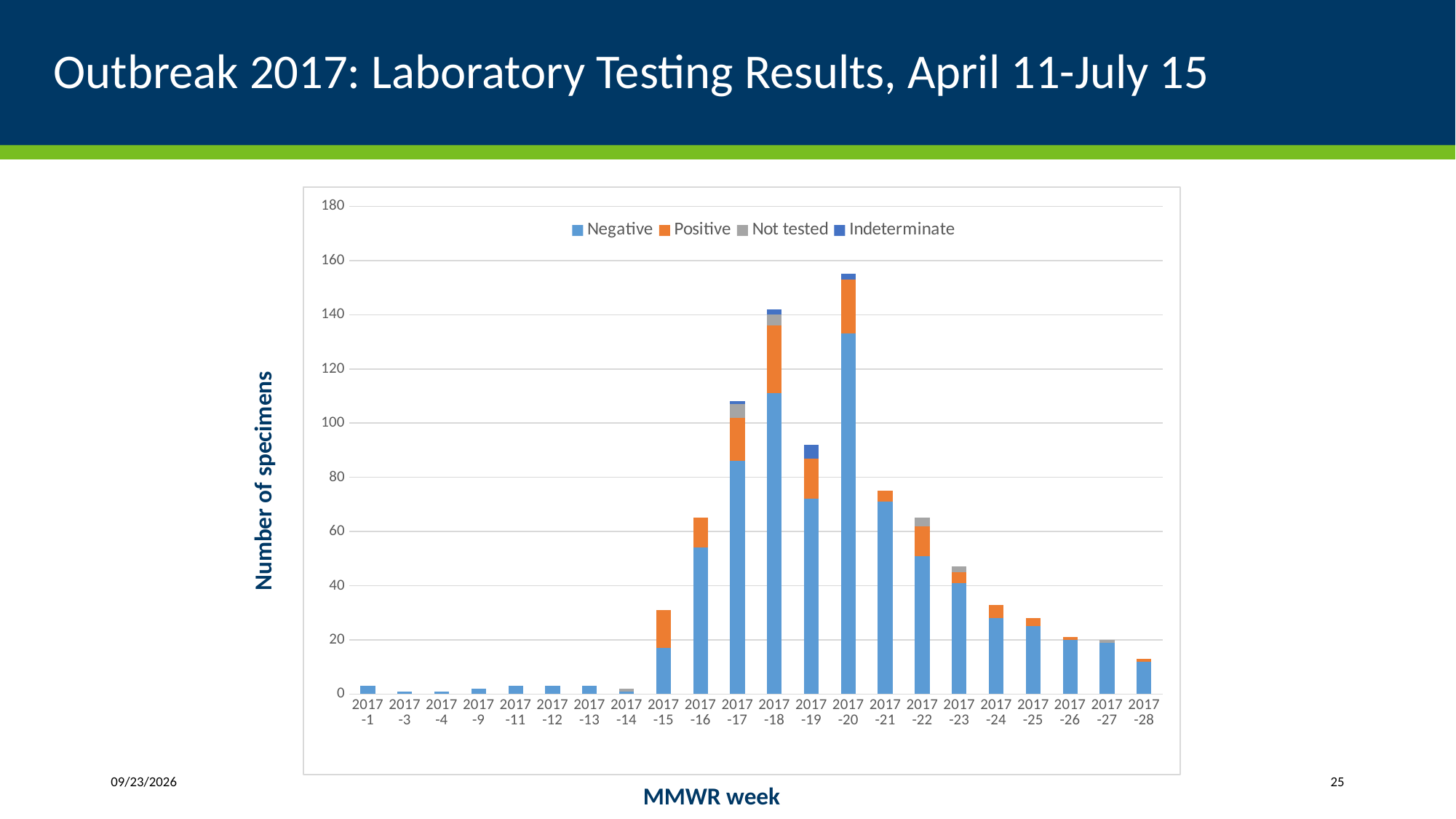
Which legend entry is shown in orange? Positive How many series does the legend list? 4 Is the total number of specimens for 2017-20 greater or less than 140? greater What kind of chart is shown on the slide? Stacked bar chart What is the label of the y axis? Number of specimens Which MMWR week has the highest total number of specimens? 2017-20 Which has a larger total number of specimens, 2017-18 or 2017-17? 2017-18 How many MMWR week categories are shown on the x axis? 22 Do the total specimen counts rise or fall from 2017-20 to 2017-28? fall Is the total number of specimens for 2017-19 greater or less than 100? less Is the total number of specimens for 2017-17 greater or less than 100? greater